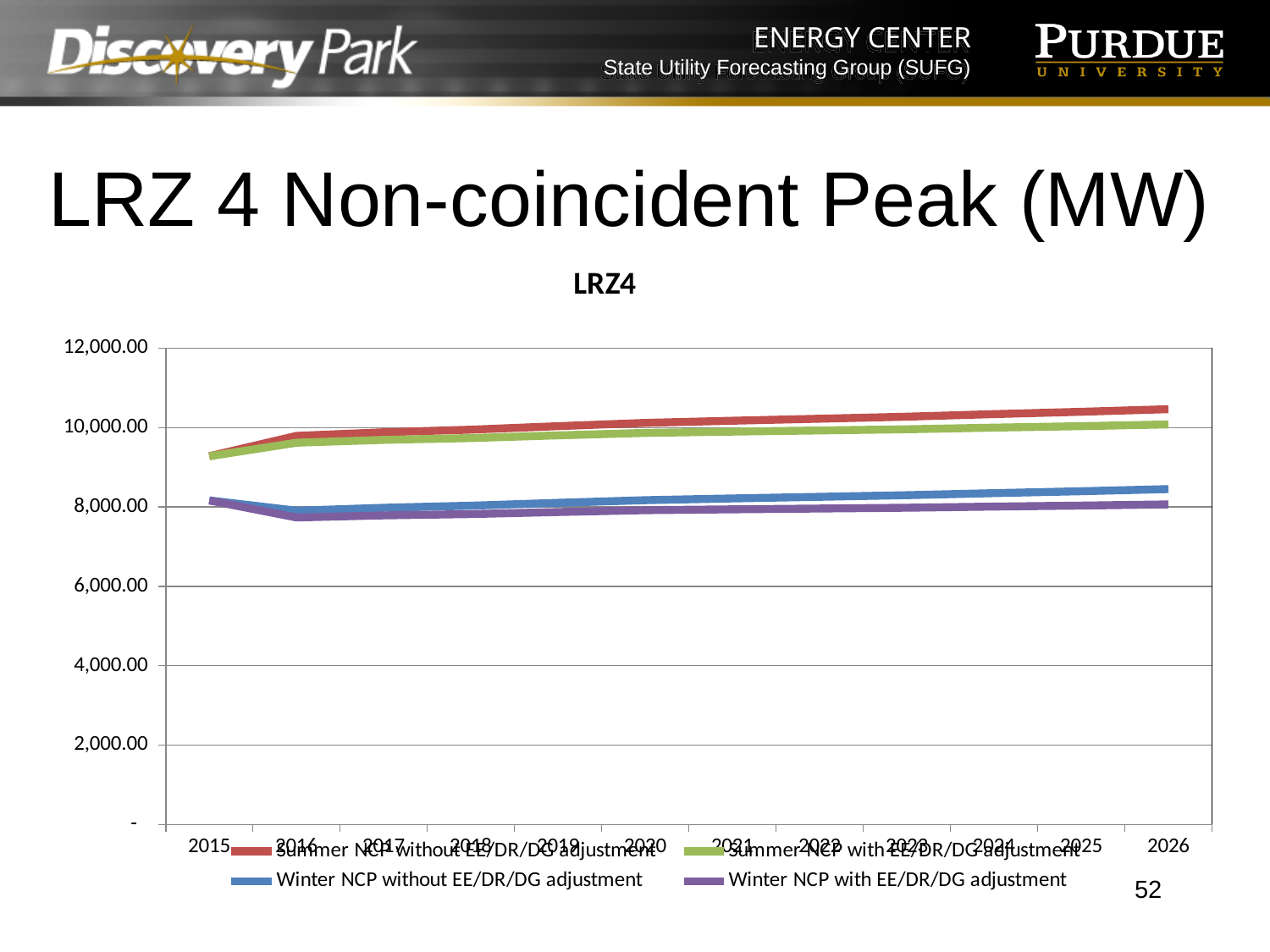
Which series has the lowest value in 2026? Winter NCP with EE/DR/DG adjustment Which series has the highest value in 2026? Summer NCP without EE/DR/DG adjustment What kind of chart is shown on the slide? Line chart Is the value for Summer NCP with EE/DR/DG adjustment in 2015 greater or less than 10,000.00? less Is the value for Winter NCP with EE/DR/DG adjustment in 2016 greater or less than 8,000.00? less How many series does the legend list? 4 Does the Summer NCP without EE/DR/DG adjustment series rise or fall from 2015 to 2026? Rise What is the title printed above the chart? LRZ4 Which series is drawn in red? Summer NCP without EE/DR/DG adjustment Is the value for Winter NCP without EE/DR/DG adjustment in 2026 greater or less than 8,000.00? greater How many years are shown along the x axis? 12